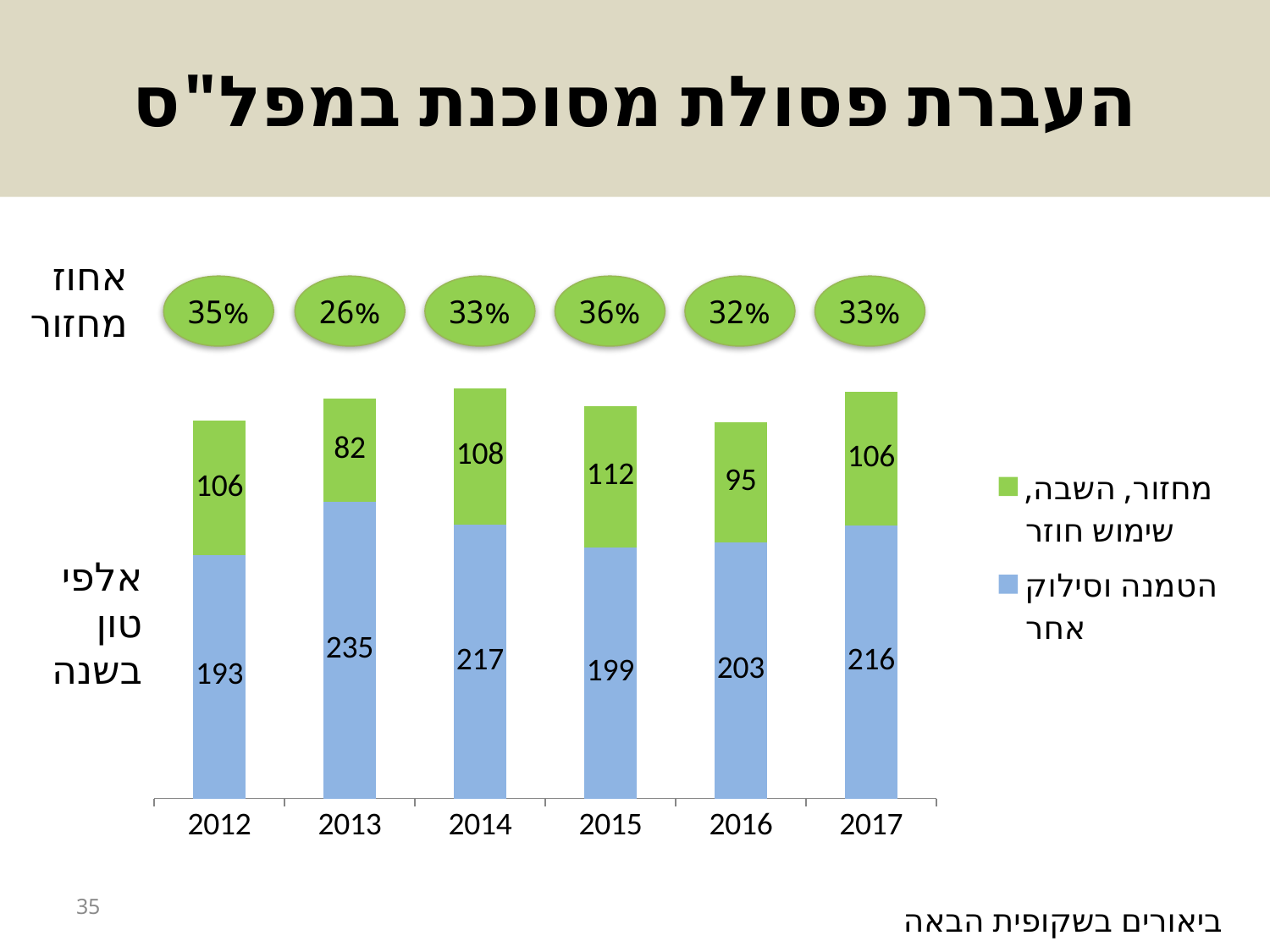
How many series does the chart legend list? 2 What is the value of the blue series (הטמנה וסילוק אחר) for 2013? 235 What type of chart is shown on the slide? stacked bar chart What is the value of the green series (מחזור, השבה, שימוש חוזר) for 2015? 112 What is the total of the stacked bar for 2017? 322 Which year has the highest recycling percentage (אחוז מחזור) shown in the green ovals? 2015 Which is larger: the green series value for 2014 or for 2016? 2014 What recycling percentage (אחוז מחזור) is shown above the bar for 2013? 26% In which year is the blue series (הטמנה וסילוק אחר) highest? 2013 In which year is the green series (מחזור, השבה, שימוש חוזר) lowest? 2013 How many years (categories) are shown on the x axis of the chart? 6 What is the difference between the blue series values for 2013 and 2012? 42